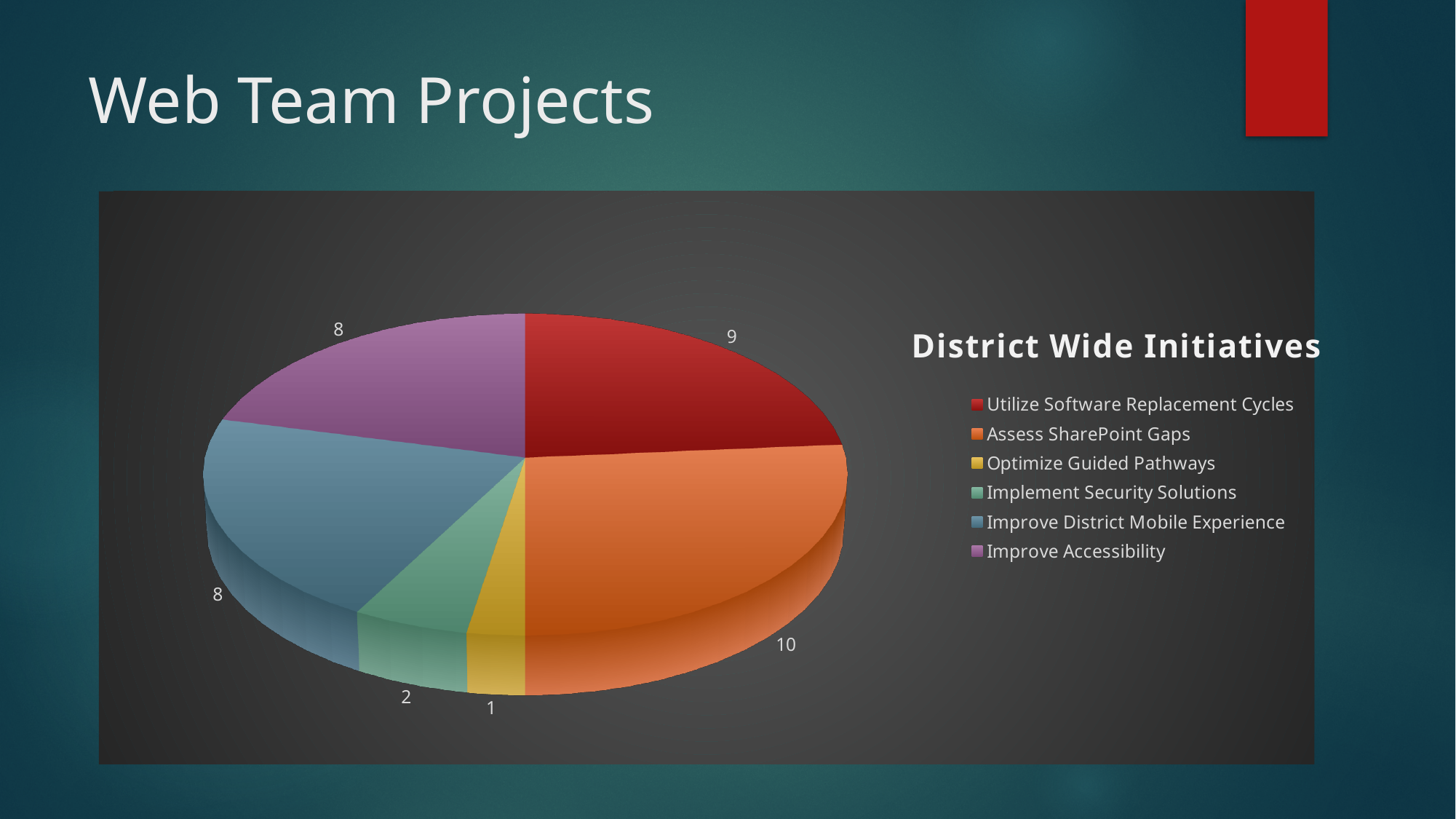
Which is larger, the value for Utilize Software Replacement Cycles or the value for Improve Accessibility? Utilize Software Replacement Cycles Which colour represents Improve District Mobile Experience in the legend? Blue What is the difference between the values for Assess SharePoint Gaps and Optimize Guided Pathways? 9 Which category has the largest slice of the pie? Assess SharePoint Gaps Which category has the smallest slice of the pie? Optimize Guided Pathways What is the value for Optimize Guided Pathways? 1 What is the value for Implement Security Solutions? 2 How many categories are shown in the pie chart? 6 What is the value for Utilize Software Replacement Cycles? 9 What is the value for Assess SharePoint Gaps? 10 What is the title of the chart? District Wide Initiatives What type of chart is shown on the slide? Pie chart